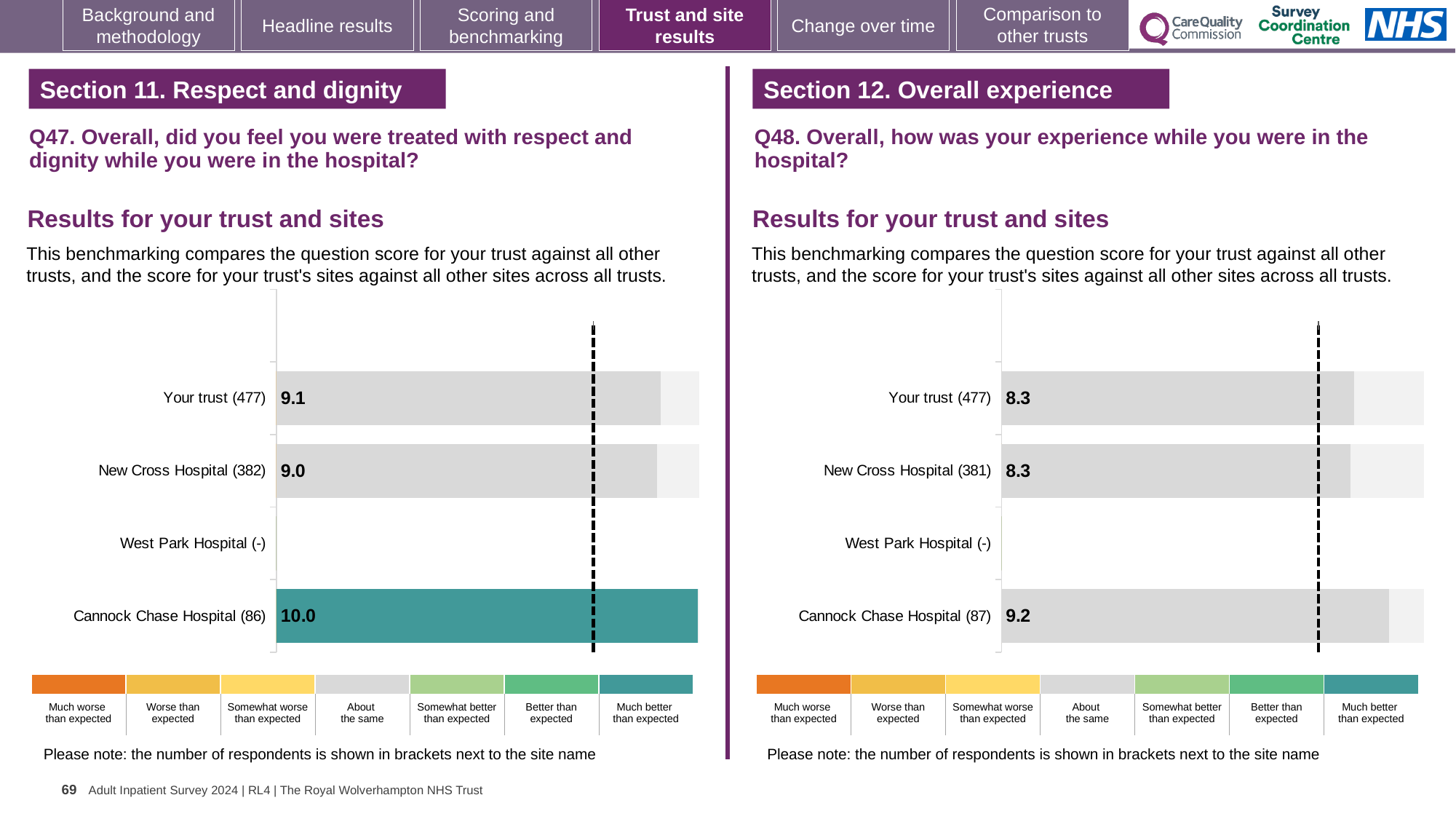
In the Q47 chart on the left, which is larger: the score for Your trust or the score for New Cross Hospital? Your trust In the Q47 chart on the left, what is the score for Your trust? 9.1 In the Q47 chart on the left, what is the score for New Cross Hospital? 9.0 In the Q47 chart on the left, what is the difference between the Cannock Chase Hospital score and the Your trust score? 0.9 In the Q48 chart on the right, what is the difference between the Cannock Chase Hospital score and the New Cross Hospital score? 0.9 In the Q47 chart on the left, what is the score for Cannock Chase Hospital? 10.0 In the Q48 chart on the right, what is the score for Cannock Chase Hospital? 9.2 In the Q48 chart on the right, which site has the highest score? Cannock Chase Hospital In the Q48 chart on the right, what is the score for Your trust? 8.3 In the Q47 chart on the left, how many respondents are shown in brackets for Cannock Chase Hospital? 86 What kind of chart is used in the Q48 chart on the right? Bar chart In the Q47 chart on the left, which site has the highest score? Cannock Chase Hospital